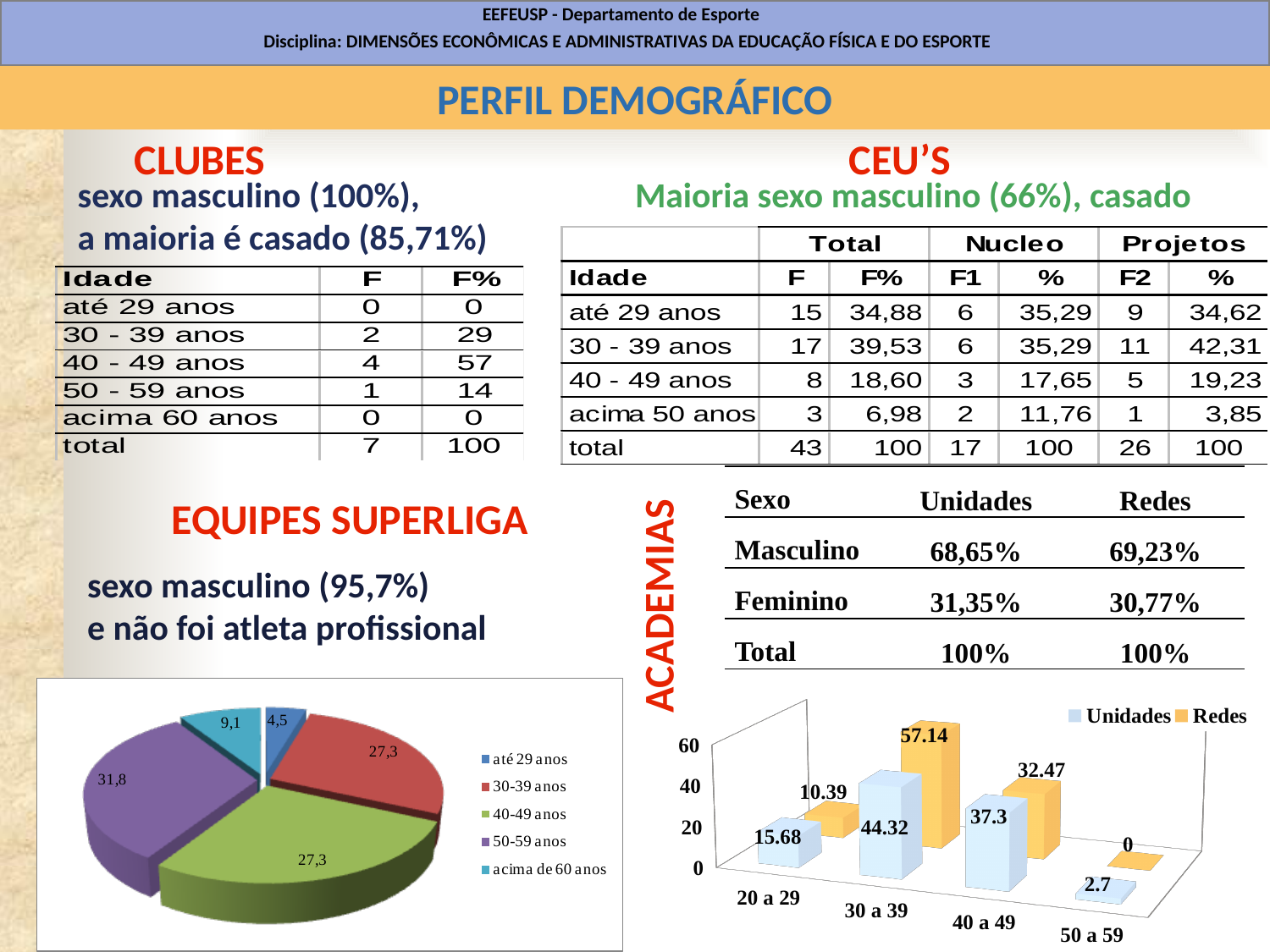
What kind of chart is shown at the bottom left of the slide? Pie chart In the bar chart at the bottom right (Academias), what is the difference between the Unidades values for '30 a 39' and '20 a 29'? 28.64 In the pie chart at the bottom left, what is the value for the '50-59 anos' slice? 31,8 In the pie chart at the bottom left, which age group has the smallest slice? até 29 anos How many slices does the pie chart at the bottom left have? 5 In the pie chart at the bottom left, which age group has the largest slice? 50-59 anos In the bar chart at the bottom right (Academias), which age group has the highest Redes value? 30 a 39 In the bar chart at the bottom right (Academias), what is the Unidades value for '50 a 59'? 2.7 In the pie chart at the bottom left, what is the value for 'acima de 60 anos'? 9,1 How many series does the legend of the bar chart at the bottom right (Academias) list? 2 In the bar chart at the bottom right (Academias), for '40 a 49', which series has the larger value, Unidades or Redes? Unidades In the bar chart at the bottom right (Academias), what is the Redes value for '30 a 39'? 57.14